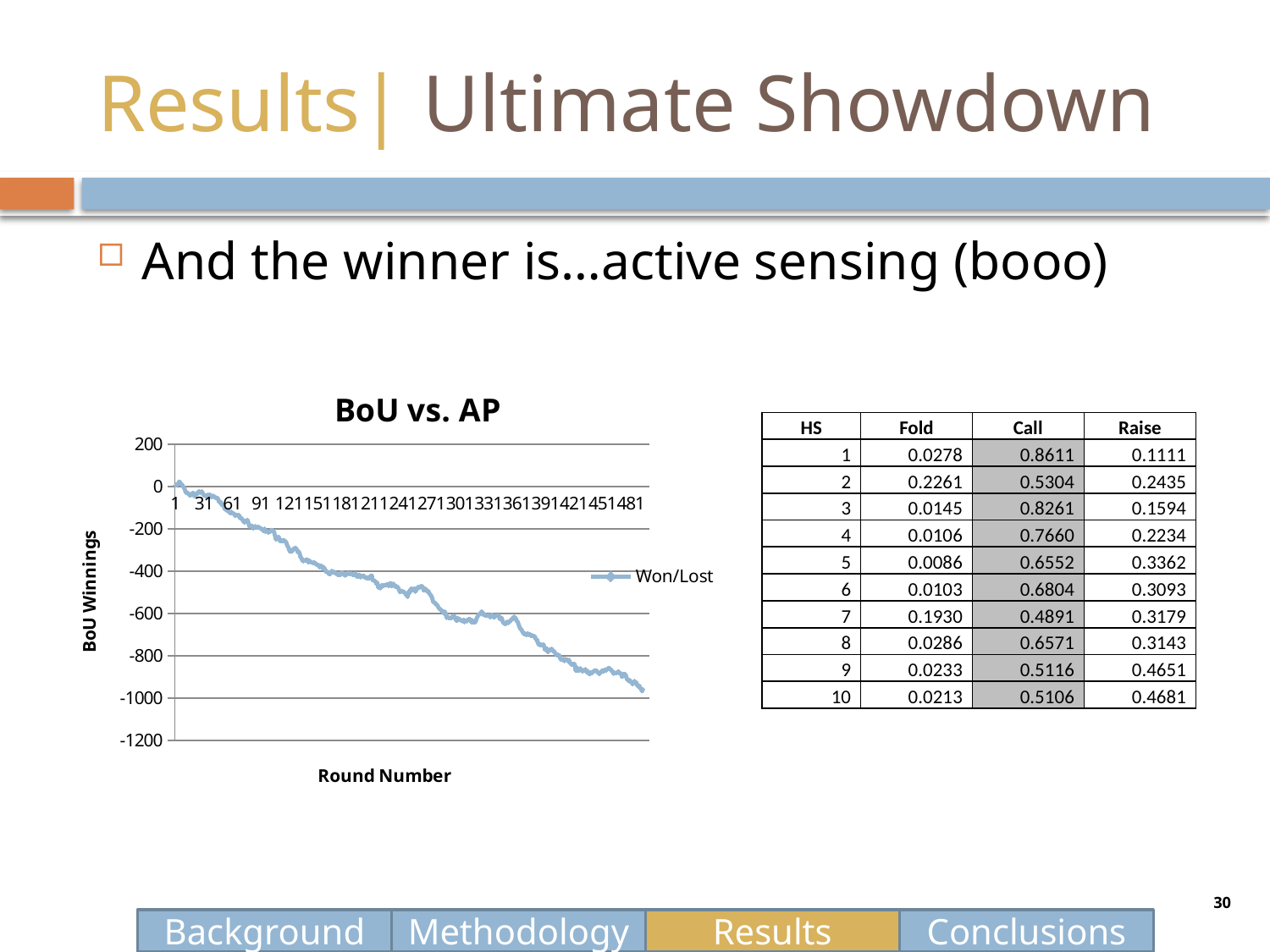
In the "BoU vs. AP" chart, is the Won/Lost value at round 31 greater or less than -200? greater In the "BoU vs. AP" chart, is the Won/Lost value at round 481 greater or less than -800? less What is the highest value shown on the y axis of the "BoU vs. AP" chart? 200 In the "BoU vs. AP" chart, is the Won/Lost value at round 151 greater or less than -600? greater Do the Won/Lost values in the "BoU vs. AP" chart rise or fall as the round number increases? fall What kind of chart is the "BoU vs. AP" chart? line chart How many series does the legend of the "BoU vs. AP" chart list? 1 What is the name of the series shown in the legend of the "BoU vs. AP" chart? Won/Lost In the "BoU vs. AP" chart, which is larger: the Won/Lost value at round 91 or at round 421? round 91 What is the title of the chart on the slide? BoU vs. AP What is the lowest value shown on the y axis of the "BoU vs. AP" chart? -1200